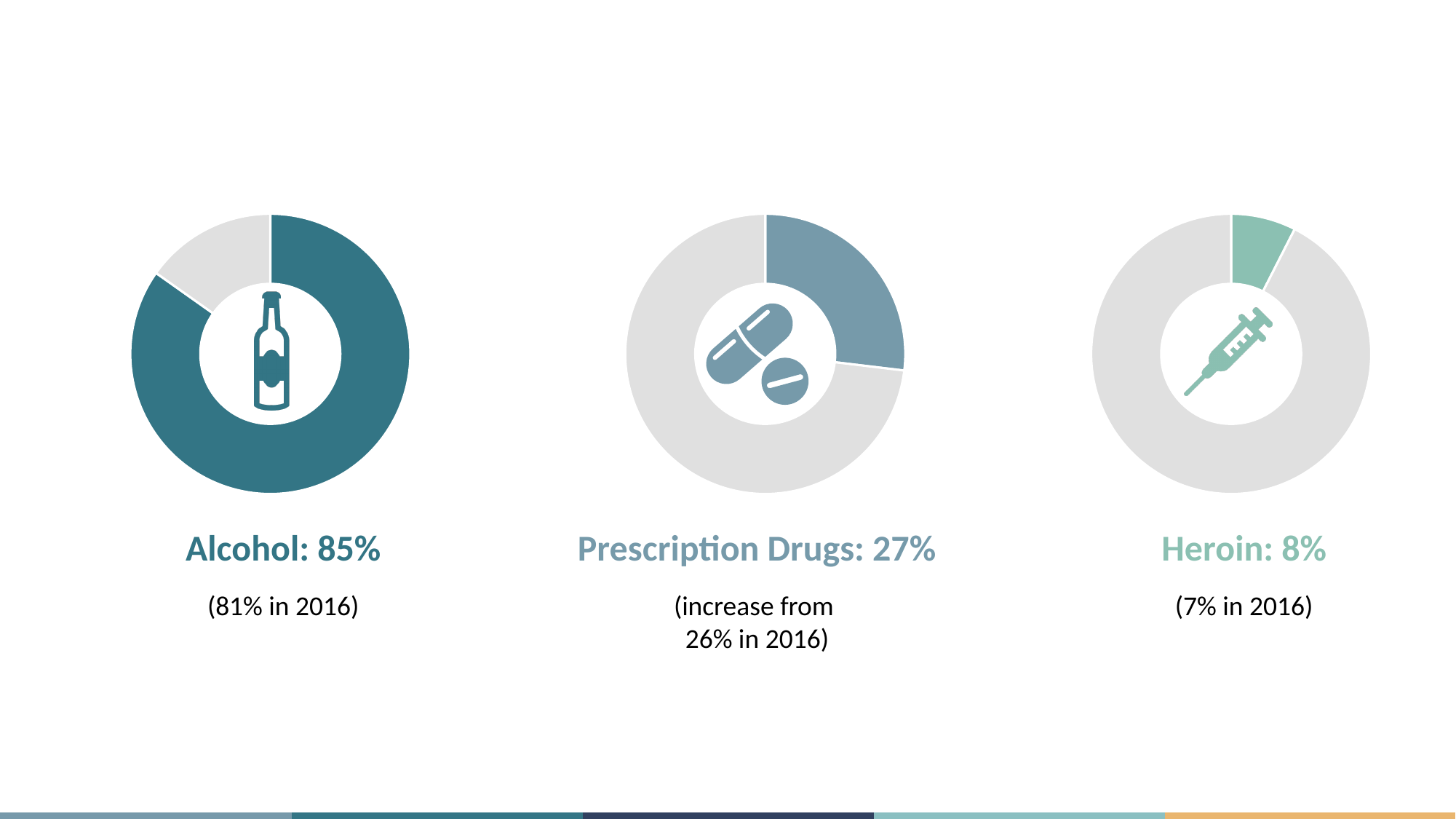
By how many percentage points did the Alcohol figure change from 2016 to the current value? 4 percentage points What kind of chart is used to show each percentage on the slide? Donut (pie) chart How many donut charts are shown on the slide? 3 What percentage is shown for Prescription Drugs? 27% What was the Alcohol percentage in 2016, according to the slide? 81% What percentage is shown for Heroin? 8% Which is larger, the Prescription Drugs percentage or the Heroin percentage? Prescription Drugs What is the difference between the Alcohol percentage and the Prescription Drugs percentage? 58 percentage points What percentage is shown for Alcohol? 85% Which of the three categories has the lowest percentage? Heroin Which of the three categories has the highest percentage? Alcohol What was the Heroin percentage in 2016, according to the slide? 7%